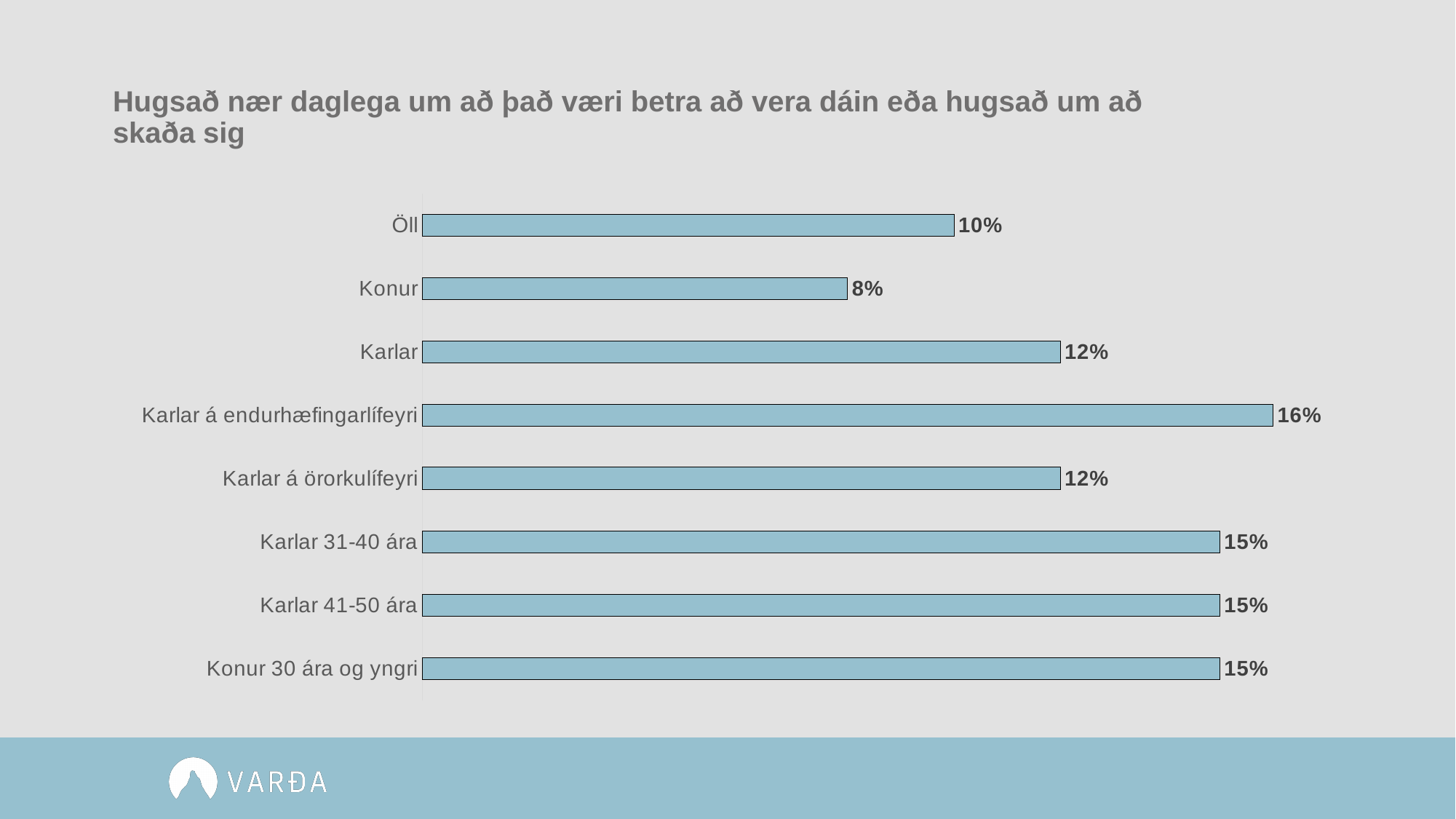
What is the value for Karlar 41-50 ára? 15% Which category has the lowest value? Konur What is the difference between the values for Karlar á endurhæfingarlífeyri and Öll? 6% What is the title of the chart? Hugsað nær daglega um að það væri betra að vera dáin eða hugsað um að skaða sig Which category has the highest value? Karlar á endurhæfingarlífeyri What is the value for Karlar á endurhæfingarlífeyri? 16% How many categories are shown in the chart? 8 What is the value for Öll? 10% What kind of chart is shown on the slide? Bar chart Which is larger, the value for Karlar 31-40 ára or the value for Karlar á örorkulífeyri? Karlar 31-40 ára What is the value for Konur? 8% What is the difference between the values for Karlar and Konur? 4%